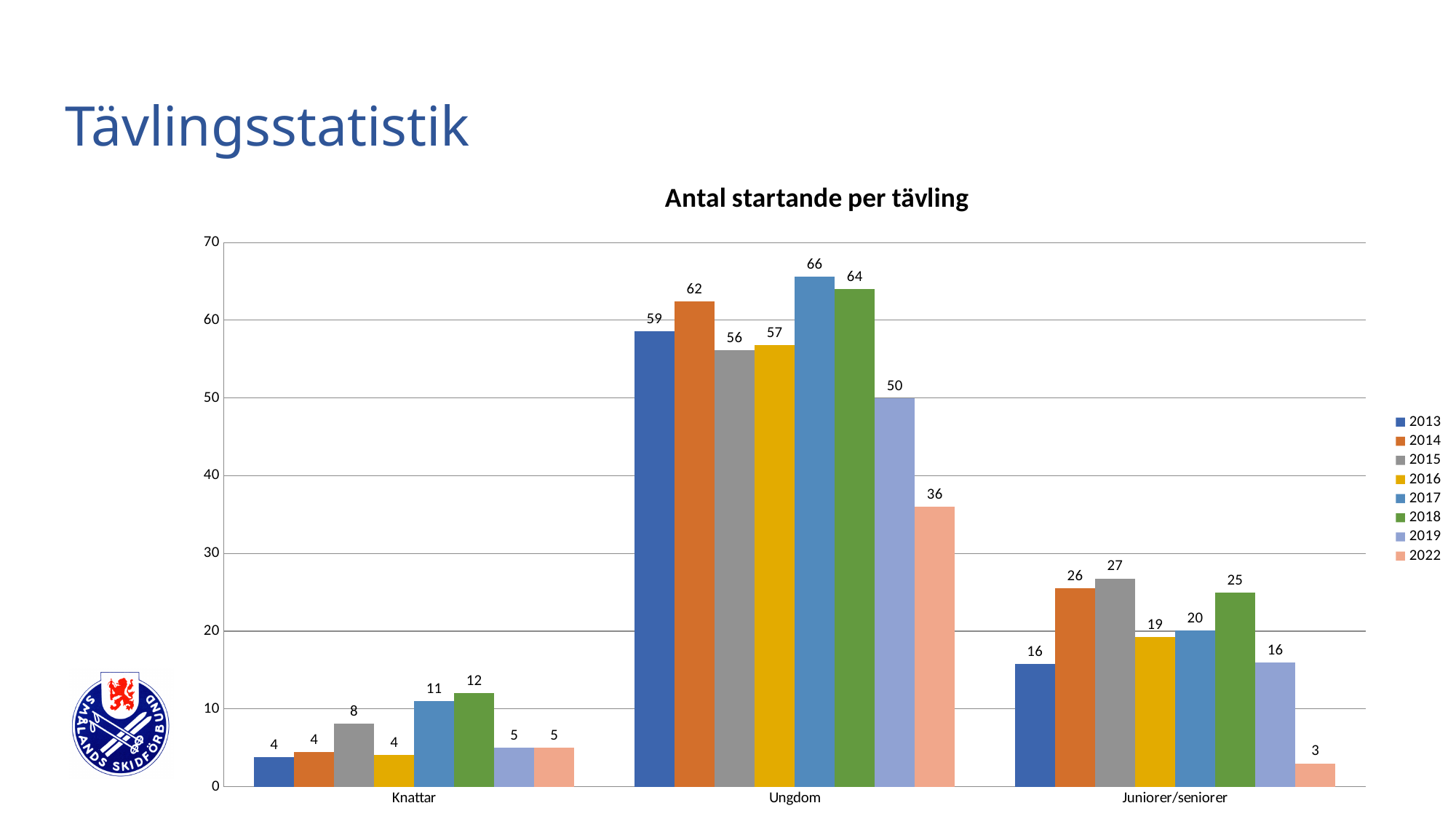
What is the value for Juniorer/seniorer in 2022? 3 How many categories are shown on the x axis? 3 Which is larger, the Juniorer/seniorer value for 2014 or for 2018? 2014 How many series does the legend list? 8 What is the value for Ungdom in 2017? 66 What is the title of the chart? Antal startande per tävling Is the value for Ungdom in 2019 greater or less than 40? greater What kind of chart is shown? bar chart What is the difference between the Ungdom values for 2017 and 2022? 30 Which year has the lowest value for Ungdom? 2022 Which year has the highest value for Juniorer/seniorer? 2015 What is the value for Knattar in 2018? 12